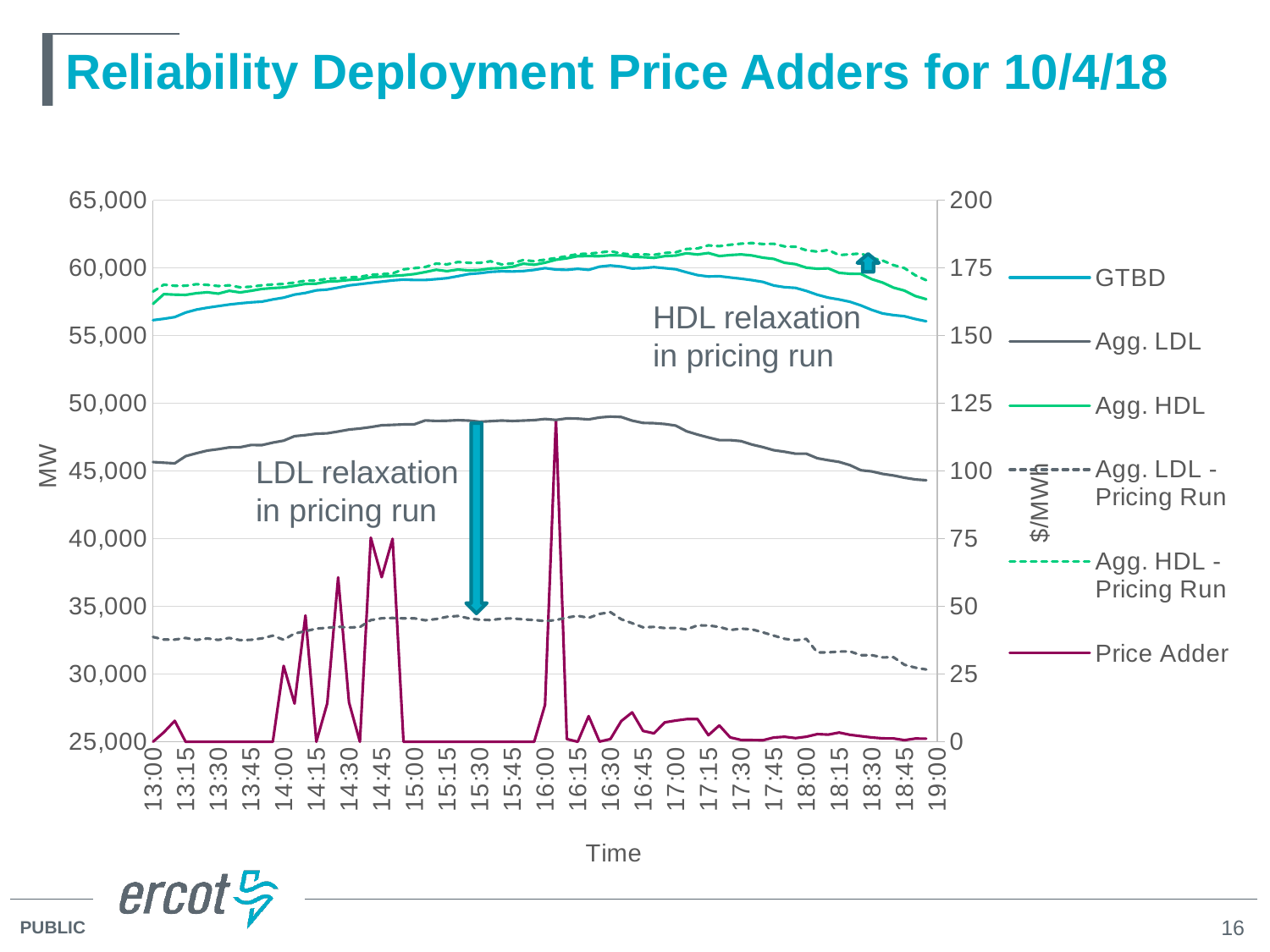
What kind of chart is shown on the slide? Line chart Is the Price Adder value at its peak around 16:00 greater or less than 100? greater Is the GTBD value at 13:00 greater or less than 55,000? greater Is the Agg. LDL value at 15:30 greater or less than 50,000? less What is the title of the chart? Reliability Deployment Price Adders for 10/4/18 How many series does the legend list? 6 Which series is higher throughout the chart: Agg. LDL or Agg. LDL - Pricing Run? Agg. LDL Does the Agg. LDL - Pricing Run series rise or fall between 17:00 and 19:00? Fall At 18:30, which is higher: Agg. HDL or GTBD? Agg. HDL What is the label of the left vertical axis? MW